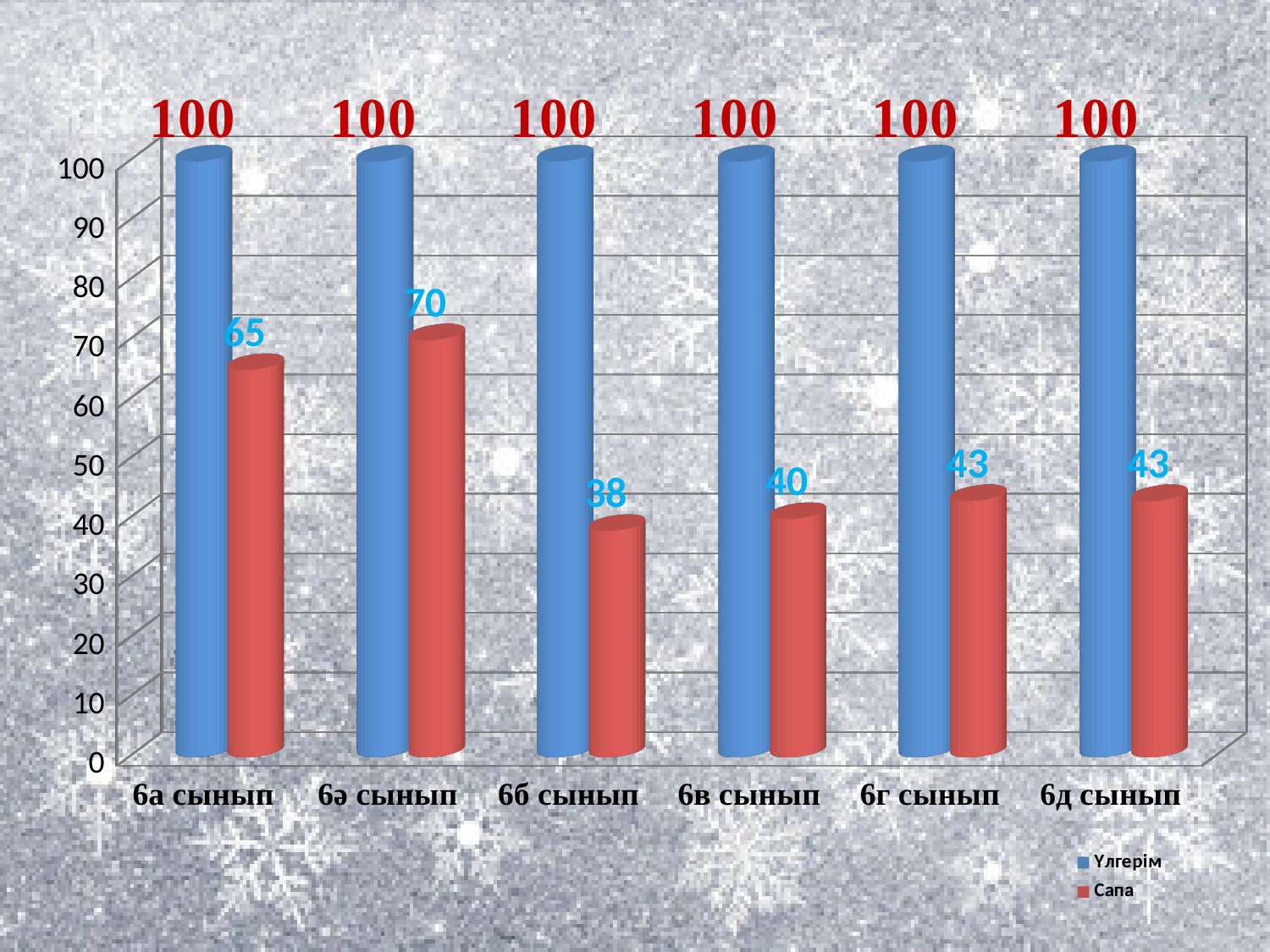
What is the Үлгерім value for 6в сынып? 100 What is the difference between the Сапа values for 6ә сынып and 6б сынып? 32 Which is larger, the Сапа value for 6а сынып or for 6в сынып? 6а сынып What is the Сапа value for 6ә сынып? 70 What is the difference between the Үлгерім and Сапа values for 6а сынып? 35 Which class has the highest Сапа value? 6ә сынып What kind of chart is shown on the slide? bar chart Which class has the lowest Сапа value? 6б сынып What is the Сапа value for 6б сынып? 38 Which colour represents the Сапа series? red How many classes are shown on the x axis? 6 How many series does the legend list? 2